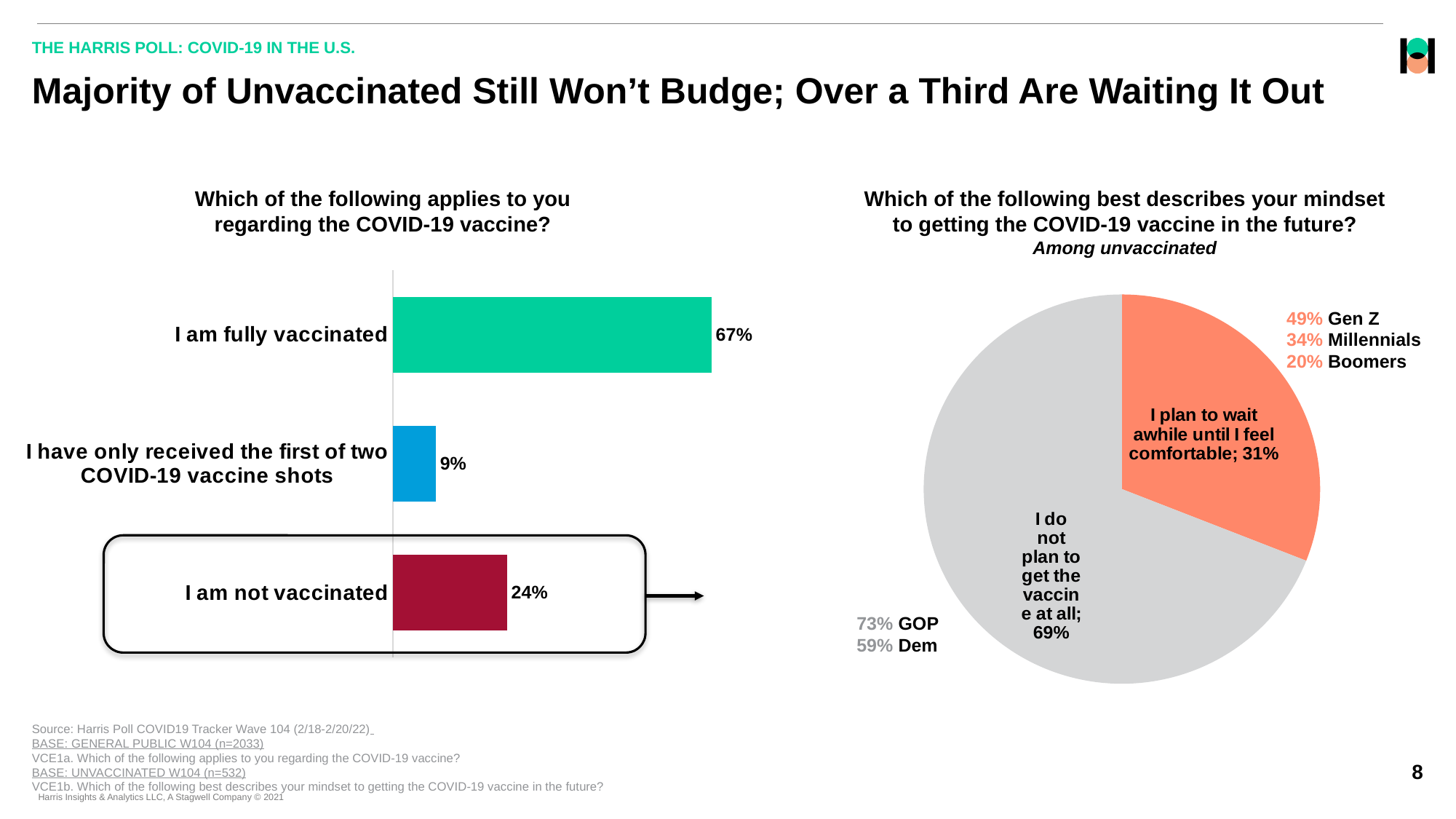
In the pie chart on the right, what share say 'I plan to wait awhile until I feel comfortable'? 31% In the bar chart on the left, which category has the lowest value? I have only received the first of two COVID-19 vaccine shots In the bar chart on the left, what is the difference between 'I am fully vaccinated' and 'I am not vaccinated'? 43% In the pie chart on the right, what share of unvaccinated respondents say 'I do not plan to get the vaccine at all'? 69% In the bar chart on the left, which category has the highest value? I am fully vaccinated In the bar chart on the left, how many categories are shown? 3 What kind of chart is the chart on the left of the slide? Bar chart In the bar chart on the left, what percentage say 'I have only received the first of two COVID-19 vaccine shots'? 9% In the pie chart on the right, which slice is larger: 'I do not plan to get the vaccine at all' or 'I plan to wait awhile until I feel comfortable'? I do not plan to get the vaccine at all In the bar chart on the left, what percentage say 'I am not vaccinated'? 24% What kind of chart is the chart on the right of the slide? Pie chart In the bar chart 'Which of the following applies to you regarding the COVID-19 vaccine?', what percentage say 'I am fully vaccinated'? 67%